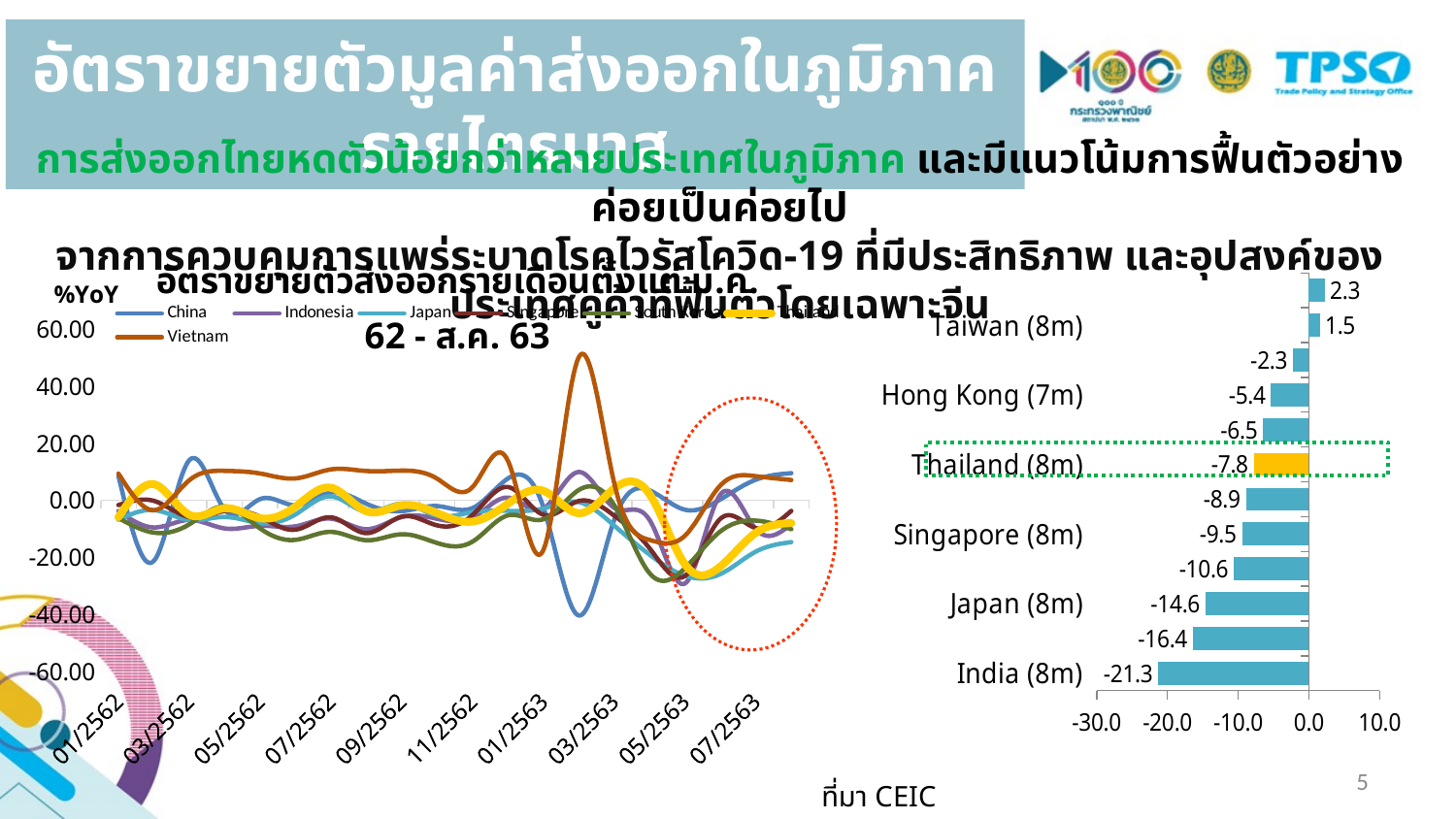
In the bar chart on the right, is the value for Thailand (8m) greater or less than -10.0? greater How many bars are plotted in the bar chart on the right? 12 In the bar chart on the right, what is the value for Japan (8m)? -14.6 In the bar chart on the right, what is the value for Thailand (8m)? -7.8 In the bar chart on the right, which is larger, the value for Taiwan (8m) or Hong Kong (7m)? Taiwan (8m) In the bar chart on the right, what is the value for Hong Kong (7m)? -5.4 In the bar chart on the right, what is the difference between the values for Thailand (8m) and Singapore (8m)? 1.7 In the bar chart on the right, what colour is the bar for Thailand (8m)? Yellow In the bar chart on the right, what is the value for India (8m)? -21.3 In the bar chart on the right, which labelled economy has the lowest value? India (8m) What kind of chart is the chart on the left of the slide? Line chart In the line chart on the left, is the peak of the Vietnam line around 03/2563 greater or less than 40.00? greater